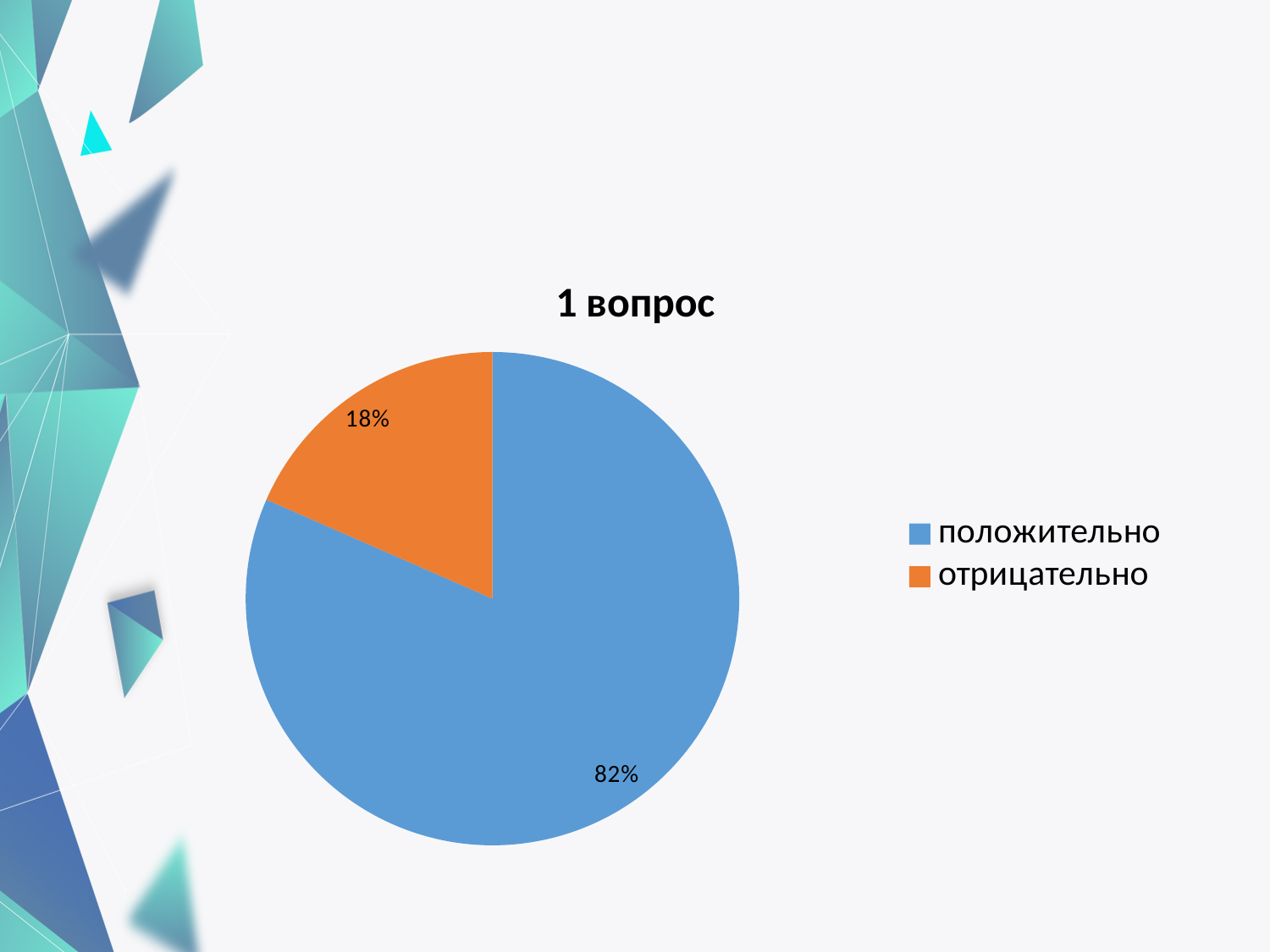
What colour is the "отрицательно" slice? orange What is the difference in percentage points between the "положительно" and "отрицательно" slices? 64 How many slices does the pie chart have? 2 Which category has the largest slice of the pie? положительно What share of the pie is labelled "положительно"? 82% How many entries does the legend list? 2 What is the title of the chart? 1 вопрос Which category has the smallest slice of the pie? отрицательно What share of the pie is labelled "отрицательно"? 18% What kind of chart is shown on the slide? pie chart Which slice is larger, "положительно" or "отрицательно"? положительно